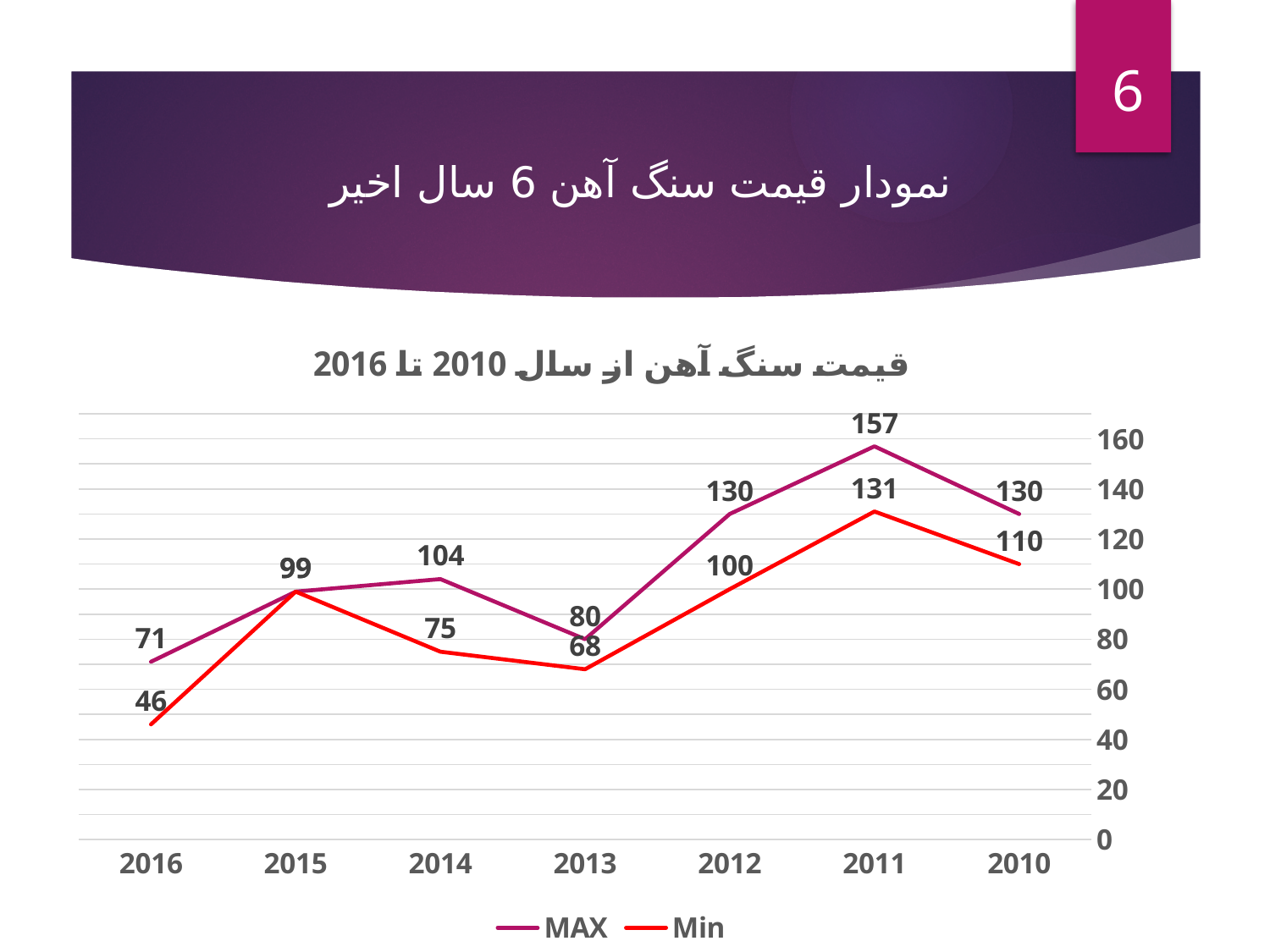
How many series does the legend list? 2 What kind of chart is shown on the slide? line chart What is the difference between the MAX and Min values in 2010? 20 What is the Min value for 2016? 46 What is the Min value for 2013? 68 What is the difference between the MAX and Min values in 2011? 26 In which year is the Min series at its lowest? 2016 What are the two entries in the legend? MAX and Min In which year is the MAX series at its highest? 2011 Which year has the larger MAX value, 2014 or 2012? 2012 What is the MAX value for 2011? 157 How many years are plotted along the x axis? 7